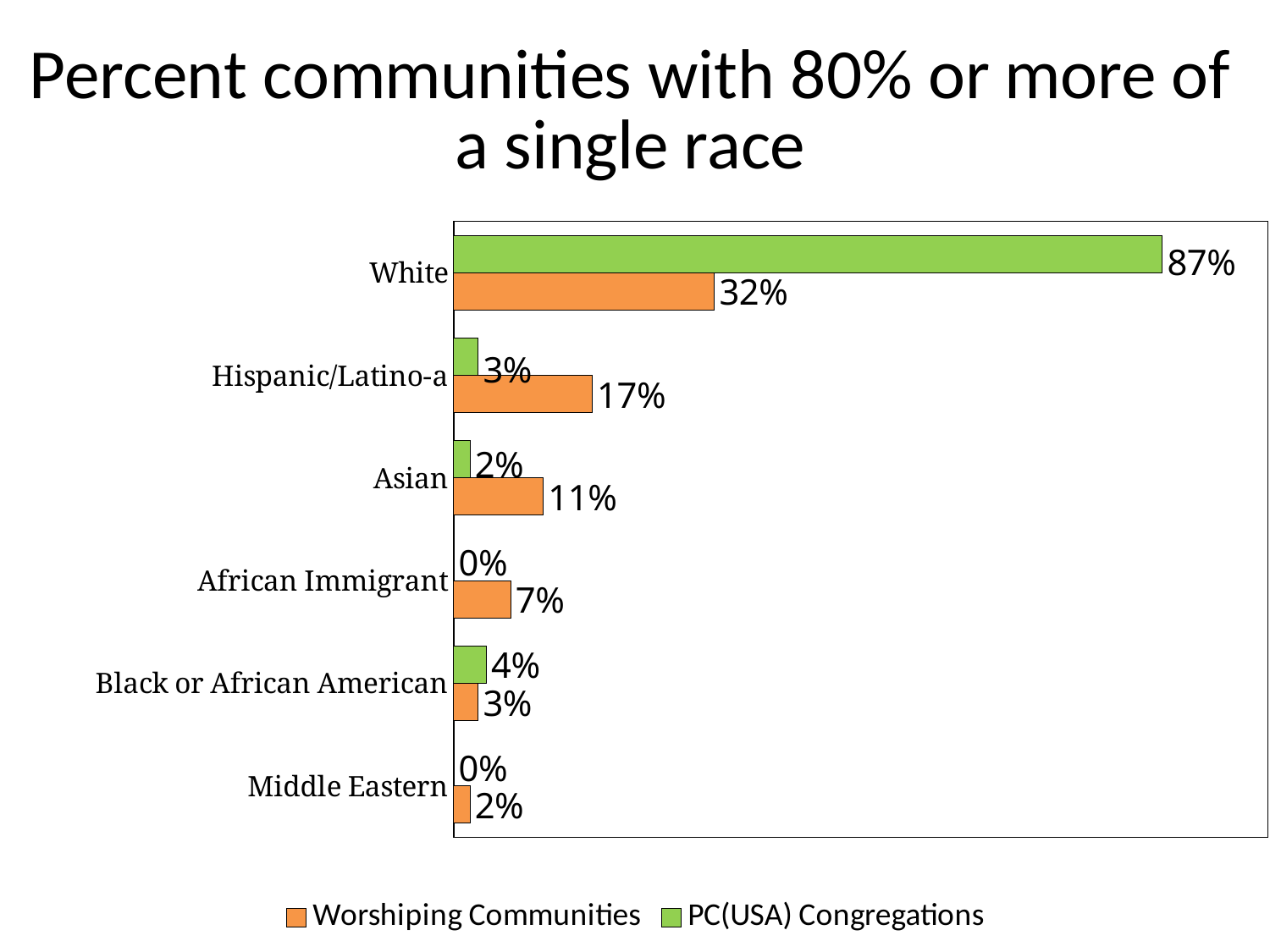
What kind of chart is shown on the slide? Bar chart In the Black or African American category, which series has the larger value, Worshiping Communities or PC(USA) Congregations? PC(USA) Congregations How many categories are shown on the chart? 6 What is the value for Worshiping Communities in the Hispanic/Latino-a category? 17% What is the value for Worshiping Communities in the African Immigrant category? 7% Which category has the lowest value for Worshiping Communities? Middle Eastern How many series does the legend list? 2 Which category has the highest value for Worshiping Communities? White What is the value for PC(USA) Congregations in the Asian category? 2% What is the difference between PC(USA) Congregations and Worshiping Communities in the White category? 55% What is the value for Worshiping Communities in the White category? 32% What is the value for PC(USA) Congregations in the White category? 87%